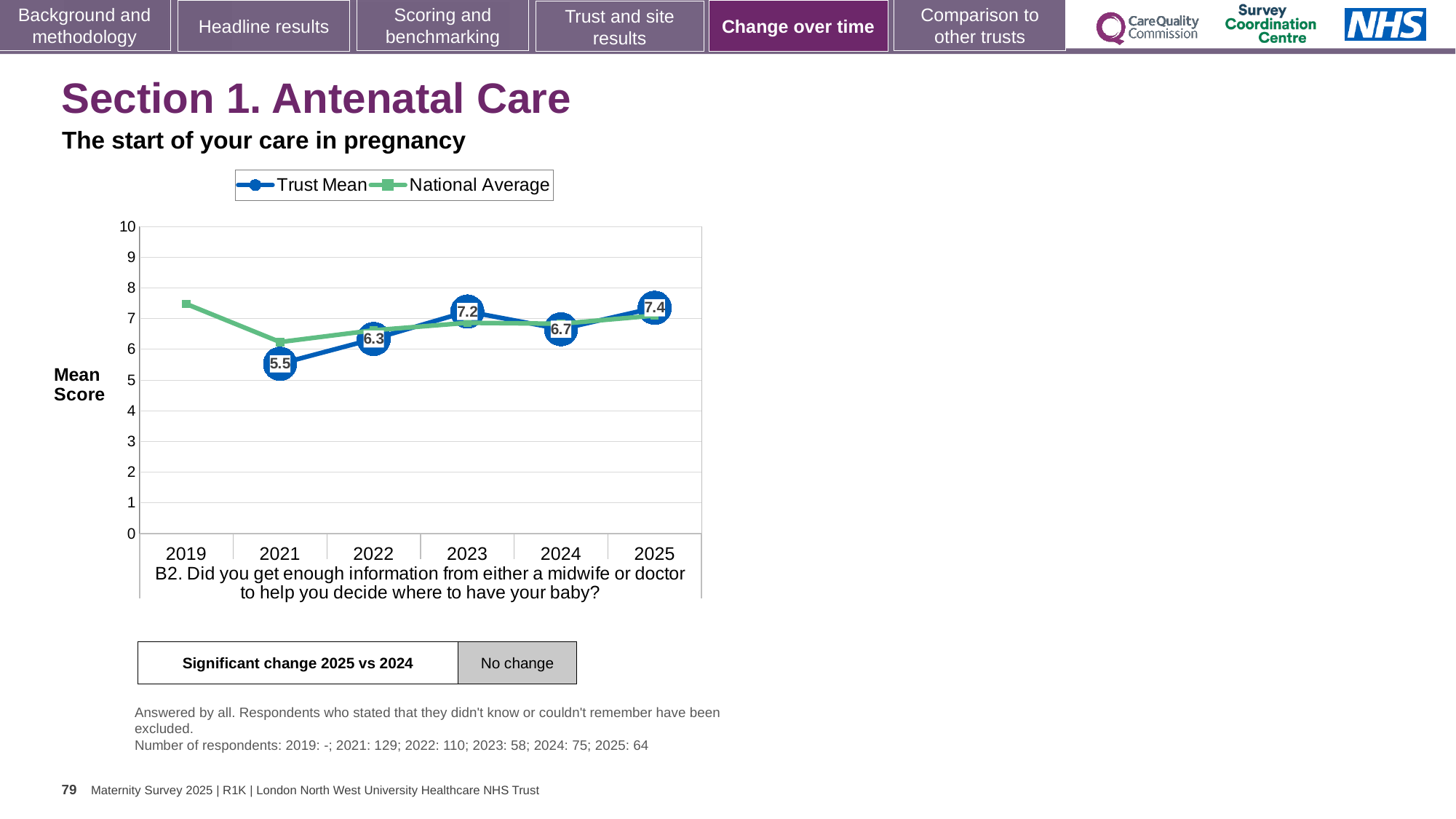
How many years are shown on the x axis? 6 What is the Trust Mean value for 2025? 7.4 Does the Trust Mean rise or fall from 2021 to 2023? rise What is the Trust Mean value for 2023? 7.2 Is the National Average value for 2019 greater or less than 7? greater In which year is the Trust Mean highest? 2025 How many series does the legend list? 2 What is the difference between the Trust Mean in 2025 and in 2021? 1.9 What kind of chart is shown on the slide? line chart Which is larger, the Trust Mean for 2023 or for 2024? 2023 What is the Trust Mean value for 2021? 5.5 In which year is the Trust Mean lowest? 2021